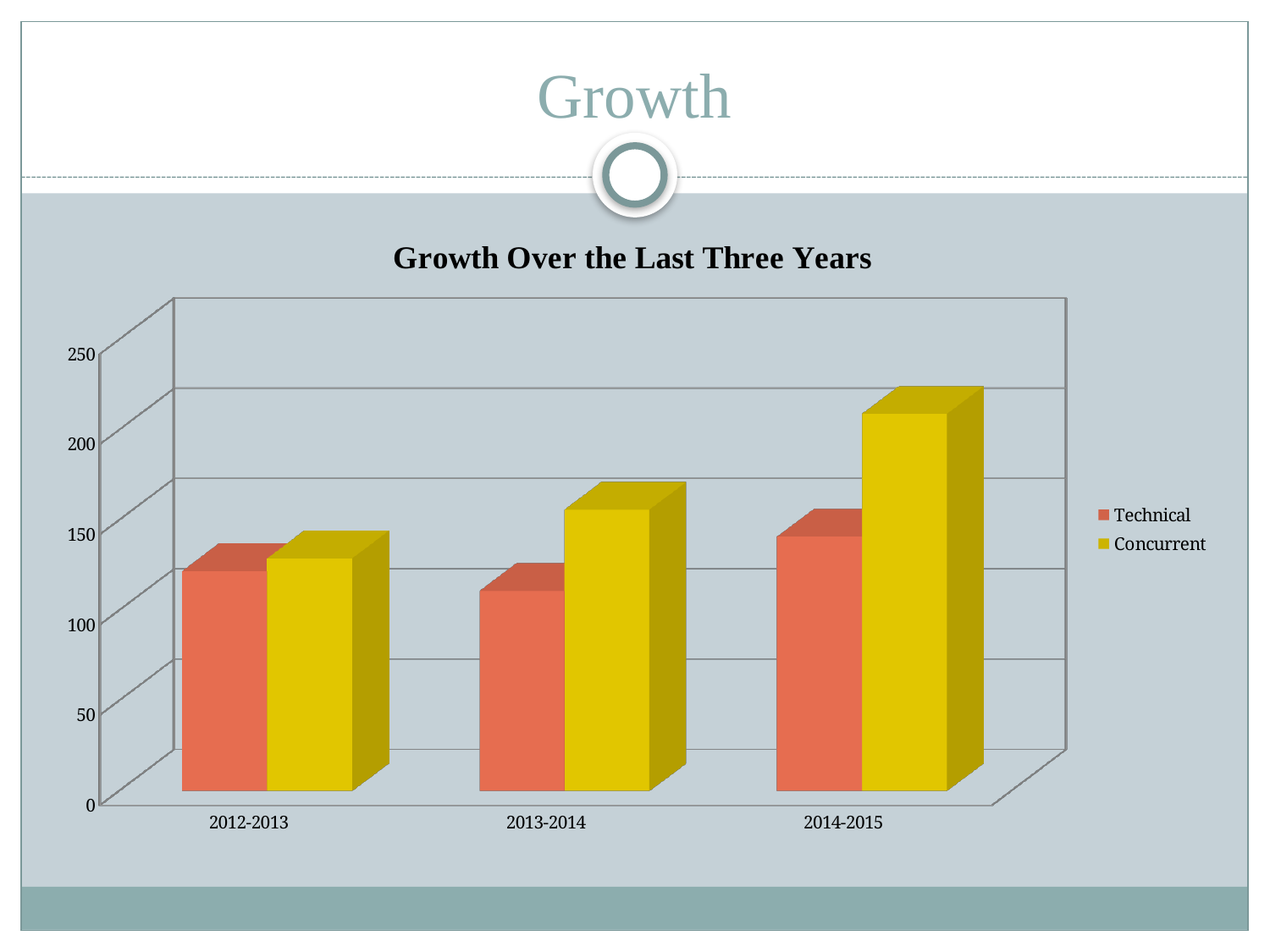
Do the Concurrent values rise or fall from 2012-2013 to 2014-2015? rise What kind of chart is shown on the slide? bar chart Which category has the lowest Technical value? 2013-2014 Is the Technical value for 2013-2014 greater or less than 150? less Is the Technical value for 2012-2013 greater or less than 100? greater How many series does the legend list? 2 In 2014-2015, which is larger, the Technical value or the Concurrent value? Concurrent How many year categories are shown on the x axis? 3 Is the Concurrent value for 2014-2015 greater or less than 200? greater What is the title of the chart? Growth Over the Last Three Years Which category has the highest Concurrent value? 2014-2015 Which series is shown in yellow in the legend? Concurrent